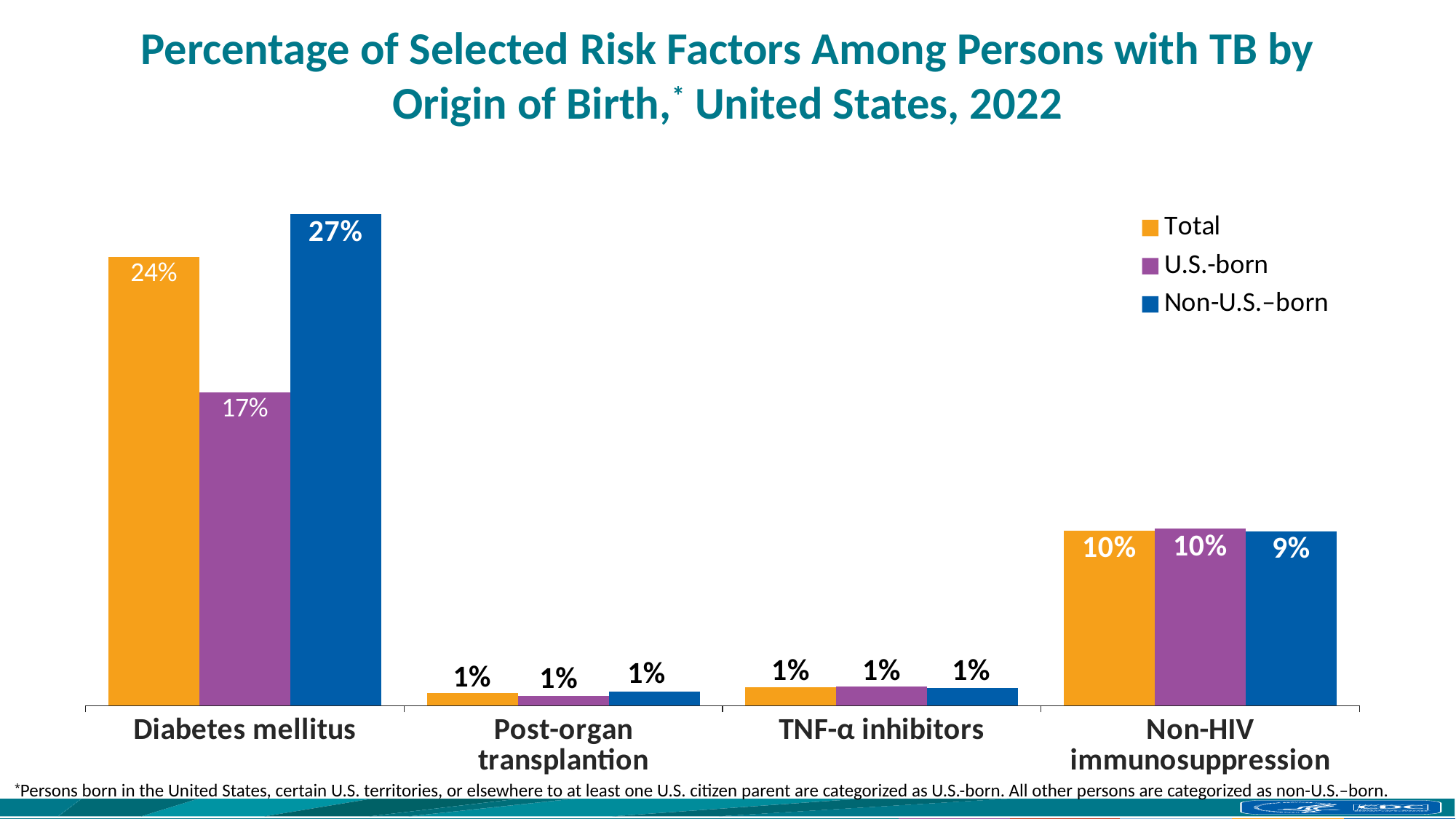
What is the difference between the Total percentages for Diabetes mellitus and Non-HIV immunosuppression? 14% What is the Non-U.S.-born percentage for Non-HIV immunosuppression? 9% What is the U.S.-born percentage for Diabetes mellitus? 17% Which risk factor has the highest Total percentage? Diabetes mellitus Which colour represents the Non-U.S.-born series in the legend? Blue For Diabetes mellitus, which is larger: the Total percentage or the U.S.-born percentage? Total How many risk factor categories are shown on the x axis? 4 What kind of chart is shown on the slide? Bar chart What is the Total percentage for Non-HIV immunosuppression? 10% What is the difference between the Non-U.S.-born and U.S.-born percentages for Diabetes mellitus? 10% How many series does the legend list? 3 What is the Non-U.S.-born percentage for Diabetes mellitus? 27%